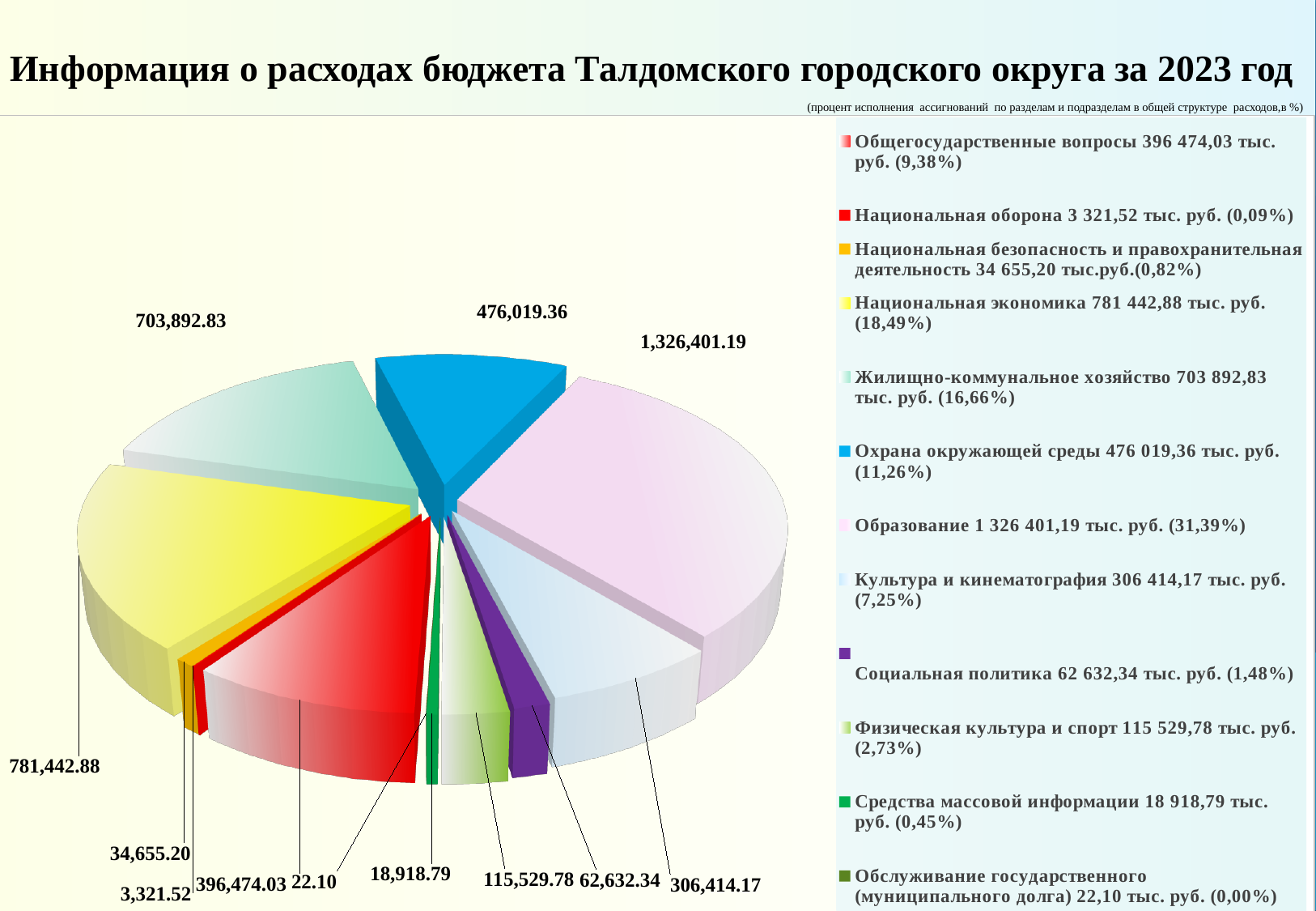
Which category has the smallest slice of the pie? Обслуживание государственного (муниципального долга) According to the legend, what share of the pie does Образование represent? 31,39% What is the data label value for the Образование slice? 1,326,401.19 How many categories (slices) does the pie chart have? 12 What is the data label value for the Средства массовой информации slice? 18,918.79 What is the difference between the values for Национальная экономика and Жилищно-коммунальное хозяйство? 77,550.05 What is the data label value for the Охрана окружающей среды slice? 476,019.36 Which category has the largest slice of the pie? Образование What type of chart is shown on the slide? Pie chart Which is larger: the value for Физическая культура и спорт or the value for Социальная политика? Физическая культура и спорт According to the legend, what share of the pie does Национальная экономика represent? 18,49% What is the difference between the values for Образование and Национальная экономика? 544,958.31